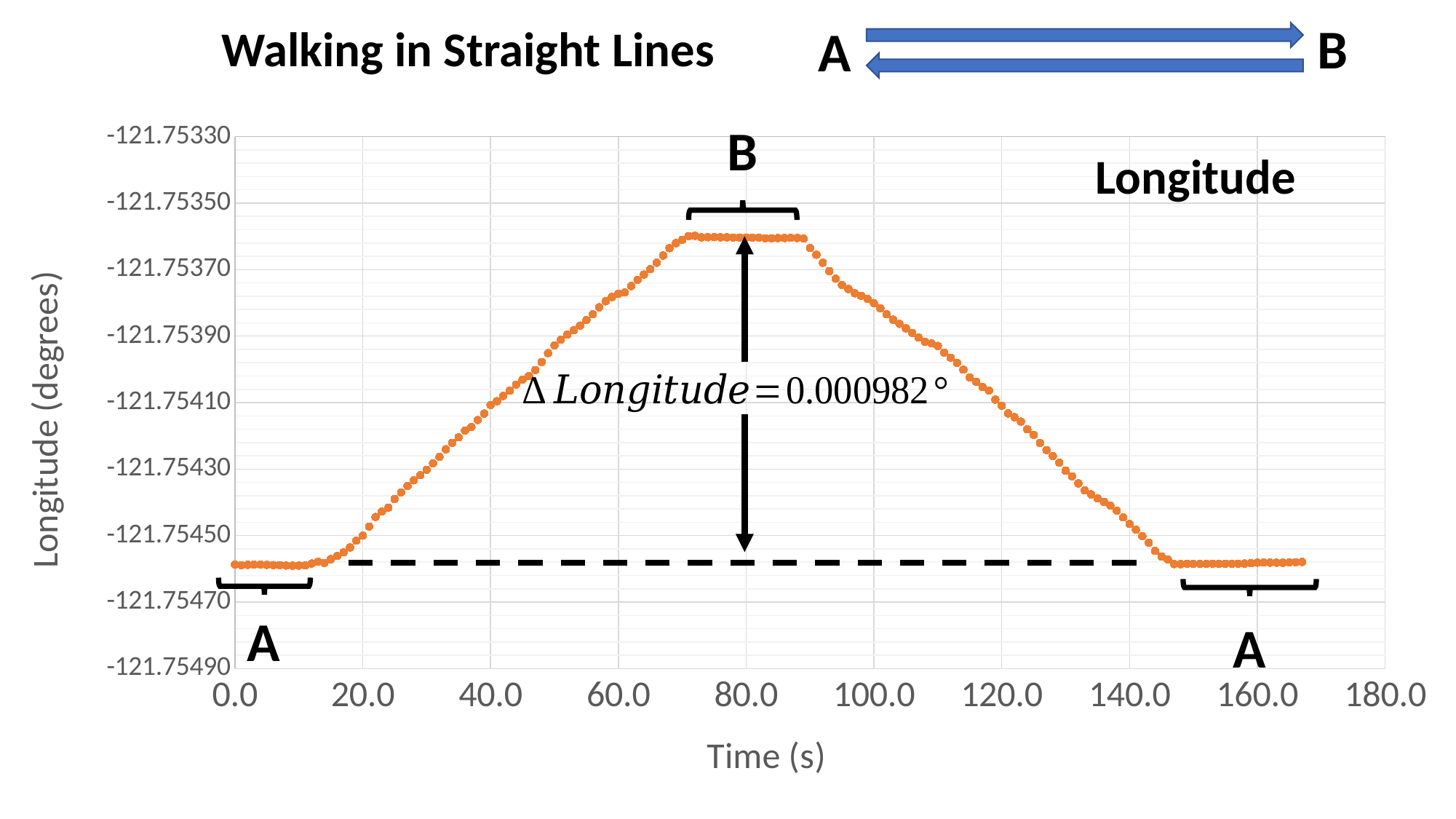
What value of ΔLongitude is annotated on the chart? 0.000982° What is the title of the chart? Longitude Is the longitude value at time 40.0 s greater or less than -121.75430? greater Is the longitude value at time 80.0 s greater or less than -121.75370? greater Between time 90.0 s and 140.0 s, does the longitude rise or fall? fall What is the label of the x axis of the chart? Time (s) Between time 20.0 s and 70.0 s, does the longitude rise or fall? rise Is the longitude value at time 0.0 s greater or less than -121.75450? less What kind of chart is shown on the slide? scatter chart Which is larger, the longitude value at time 80.0 s or at time 160.0 s? 80.0 s Which labelled position, A or B, corresponds to the highest longitude values on the chart? B